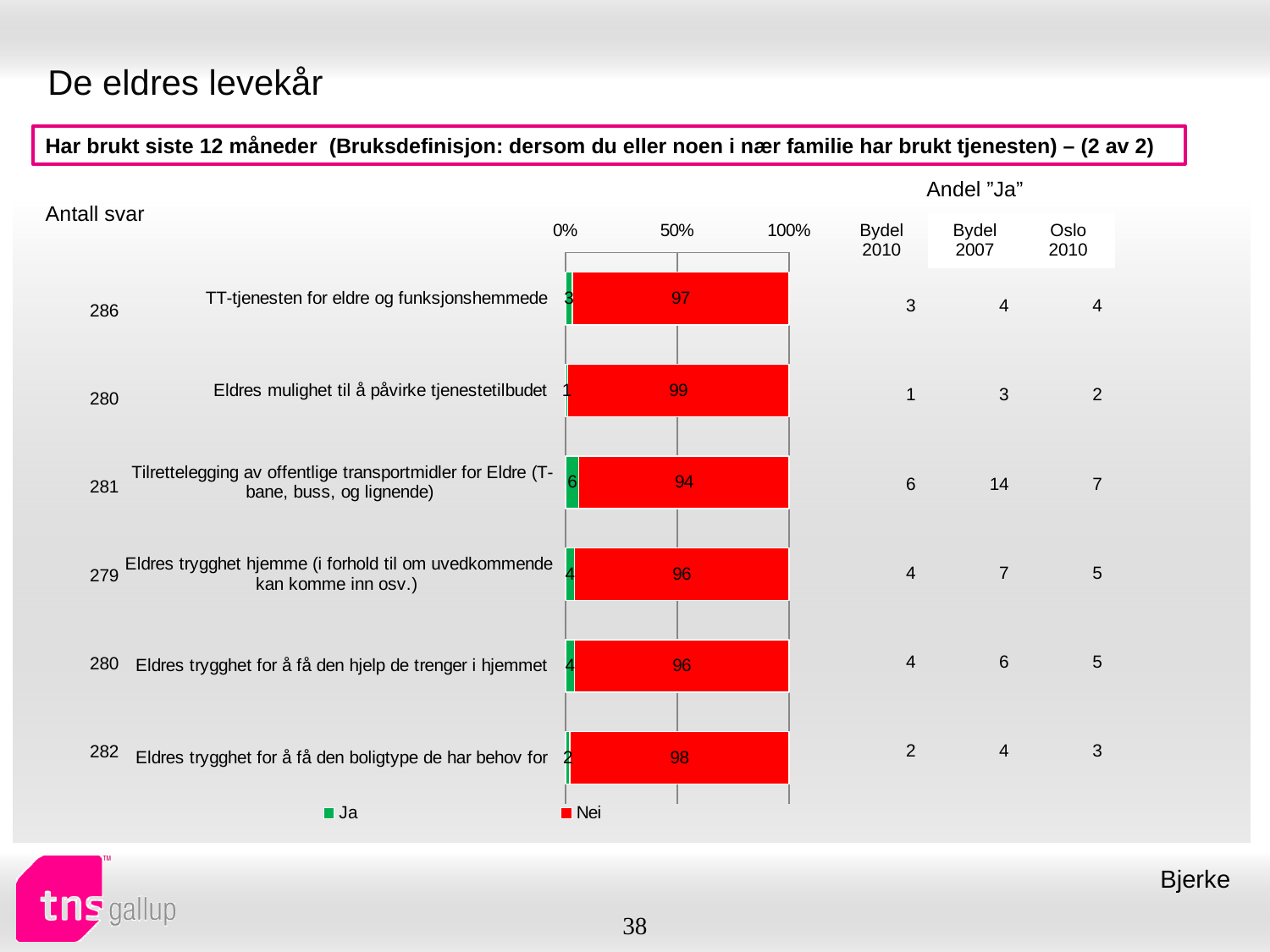
What is the "Nei" value for "TT-tjenesten for eldre og funksjonshemmede"? 97 How many series does the legend list? 2 What is the "Nei" value for "Eldres trygghet for å få den boligtype de har behov for"? 98 Which category has the lowest "Nei" value? Tilrettelegging av offentlige transportmidler for Eldre (T-bane, buss, og lignende) What is the "Ja" value for "Tilrettelegging av offentlige transportmidler for Eldre (T-bane, buss, og lignende)"? 6 Which category has the highest "Ja" value? Tilrettelegging av offentlige transportmidler for Eldre (T-bane, buss, og lignende) What is the difference between the "Nei" values for "Eldres mulighet til å påvirke tjenestetilbudet" and "Tilrettelegging av offentlige transportmidler for Eldre (T-bane, buss, og lignende)"? 5 What kind of chart is shown on the slide? Stacked bar chart Which colour represents "Nei" in the chart? Red What is the "Nei" value for "Eldres mulighet til å påvirke tjenestetilbudet"? 99 How many categories are shown in the chart? 6 Which is larger: the "Nei" value for "TT-tjenesten for eldre og funksjonshemmede" or for "Eldres trygghet for å få den boligtype de har behov for"? Eldres trygghet for å få den boligtype de har behov for